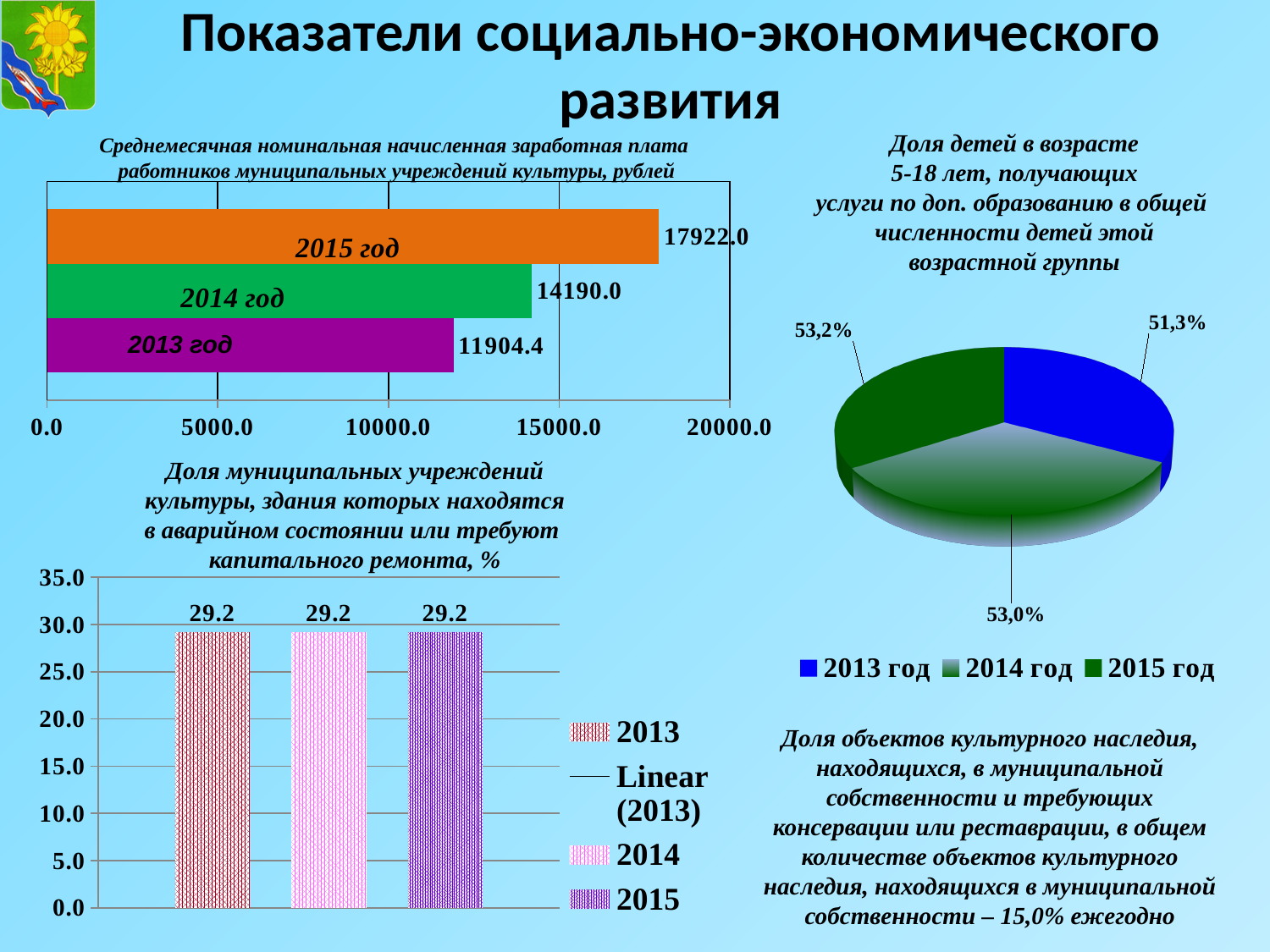
In the chart 'Доля муниципальных учреждений культуры, здания которых находятся в аварийном состоянии или требуют капитального ремонта, %', is the value for 2015 greater or less than 30.0? less In the pie chart 'Доля детей в возрасте 5-18 лет, получающих услуги по доп. образованию', what is the share for 2013 год? 51,3% In the chart 'Среднемесячная номинальная начисленная заработная плата работников муниципальных учреждений культуры, рублей', which year has the highest value? 2015 год In the pie chart 'Доля детей в возрасте 5-18 лет, получающих услуги по доп. образованию', what is the share for 2015 год? 53,2% In the chart 'Доля муниципальных учреждений культуры, здания которых находятся в аварийном состоянии или требуют капитального ремонта, %', what is the value for 2014? 29.2 In the pie chart 'Доля детей в возрасте 5-18 лет, получающих услуги по доп. образованию', which year has the smallest share? 2013 год What kind of chart is 'Среднемесячная номинальная начисленная заработная плата работников муниципальных учреждений культуры, рублей'? bar chart In the chart 'Среднемесячная номинальная начисленная заработная плата работников муниципальных учреждений культуры, рублей', do the values rise or fall from 2013 to 2015? rise In the chart 'Среднемесячная номинальная начисленная заработная плата работников муниципальных учреждений культуры, рублей', what is the value for 2015 год? 17922.0 In the chart 'Среднемесячная номинальная начисленная заработная плата работников муниципальных учреждений культуры, рублей', what is the value for 2013 год? 11904.4 In the chart 'Среднемесячная номинальная начисленная заработная плата работников муниципальных учреждений культуры, рублей', what is the difference between the 2015 год and 2014 год values? 3732.0 How many entries does the legend of the pie chart 'Доля детей в возрасте 5-18 лет, получающих услуги по доп. образованию' list? 3